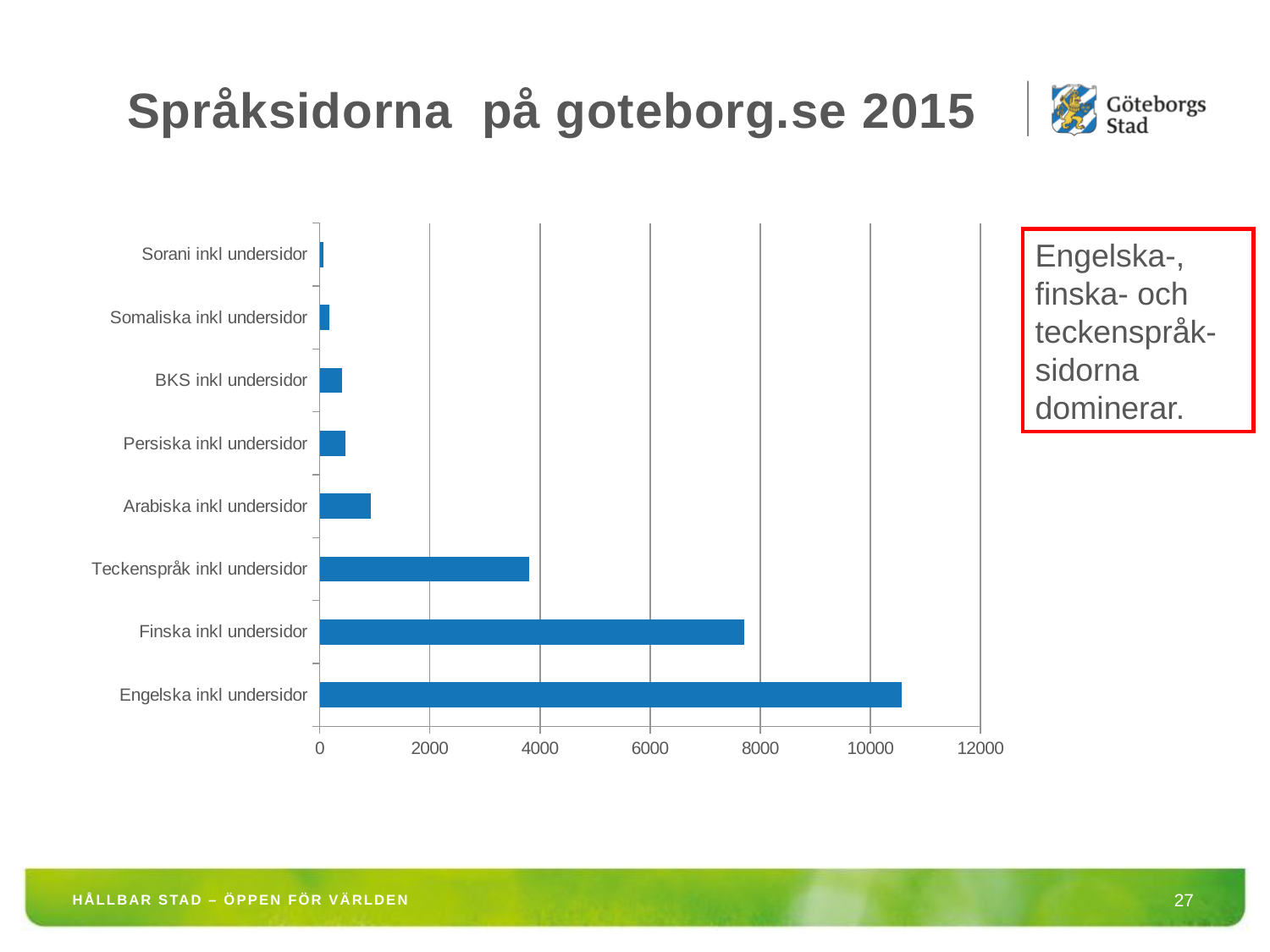
What is the title of the slide containing the chart? Språksidorna på goteborg.se 2015 Which is larger, the value for Arabiska inkl undersidor or Persiska inkl undersidor? Arabiska inkl undersidor What is the highest value shown on the horizontal axis of the chart? 12000 What kind of chart is shown on the slide? bar chart How many categories are plotted in the chart? 8 Which is larger, the value for Finska inkl undersidor or Teckenspråk inkl undersidor? Finska inkl undersidor Is the value for Arabiska inkl undersidor greater or less than 2000? less Which category has the highest value in the chart? Engelska inkl undersidor Is the value for Teckenspråk inkl undersidor greater or less than 4000? less Which category has the lowest value in the chart? Sorani inkl undersidor Is the value for Finska inkl undersidor greater or less than 8000? less